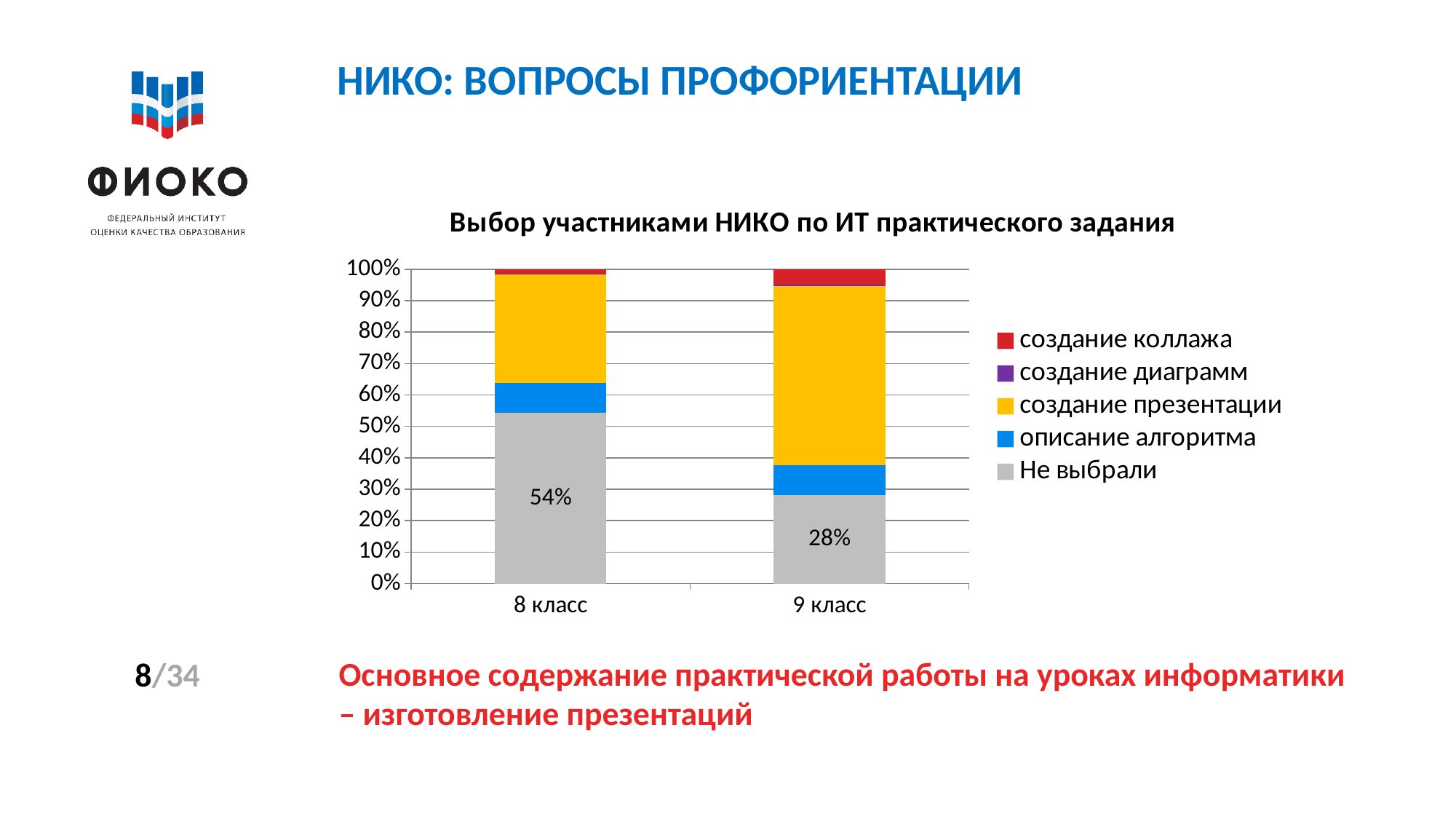
How many series does the legend list? 5 What kind of chart is shown on the slide? Stacked bar chart Does the «Не выбрали» share rise or fall from 8 класс to 9 класс? Falls Which class has the larger «Не выбрали» share, 8 класс or 9 класс? 8 класс What is the title of the chart? Выбор участниками НИКО по ИТ практического задания Which series has the largest share in the 9 класс bar? создание презентации How many categories are shown on the x axis? 2 What is the difference between the «Не выбрали» values for 8 класс and 9 класс? 26% What is the value of «Не выбрали» for 9 класс? 28% Is the value for «описание алгоритма» in 8 класс greater or less than 20%? less Is the value for «создание презентации» in 9 класс greater or less than 50%? greater What is the value of «Не выбрали» for 8 класс? 54%